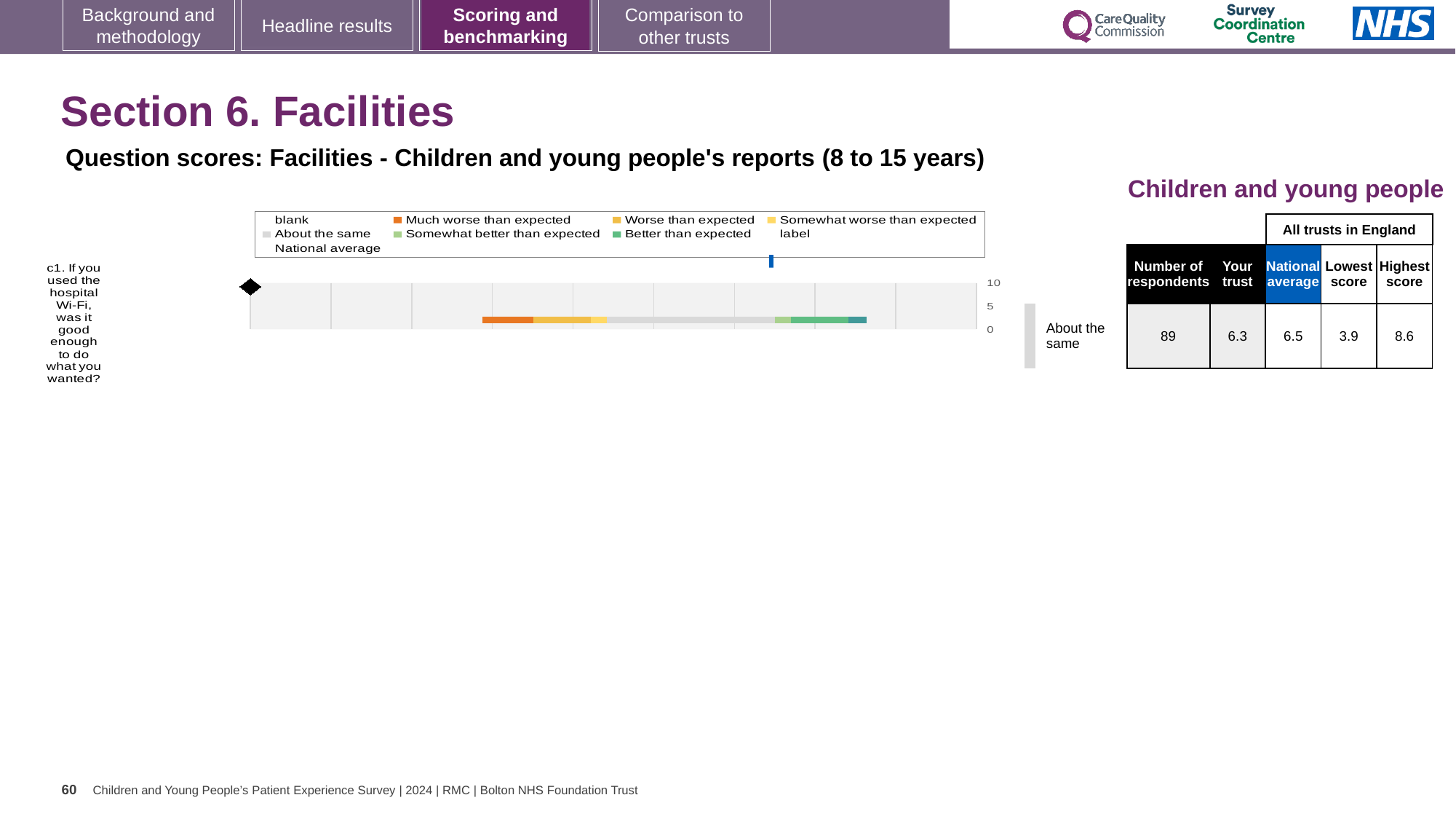
What benchmark category is the trust's result for question c1 assigned to, as shown next to the chart? About the same How many question categories are plotted in the chart? 1 What is the difference between the highest score (8.6) and the lowest score (3.9) for question c1? 4.7 What kind of chart is shown on the slide? bar chart According to the table beside the chart, how many respondents answered question c1? 89 According to the table beside the chart, what is the highest score among all trusts in England for question c1? 8.6 According to the table beside the chart, what is the 'Your trust' score for question c1? 6.3 In the chart legend, what colour represents 'Much worse than expected'? orange Which is larger for question c1: the 'Your trust' score or the national average? National average According to the table beside the chart, what is the national average score for question c1? 6.5 According to the table beside the chart, what is the lowest score among all trusts in England for question c1? 3.9 What is the label of the single category plotted in the chart? c1. If you used the hospital Wi-Fi, was it good enough to do what you wanted?